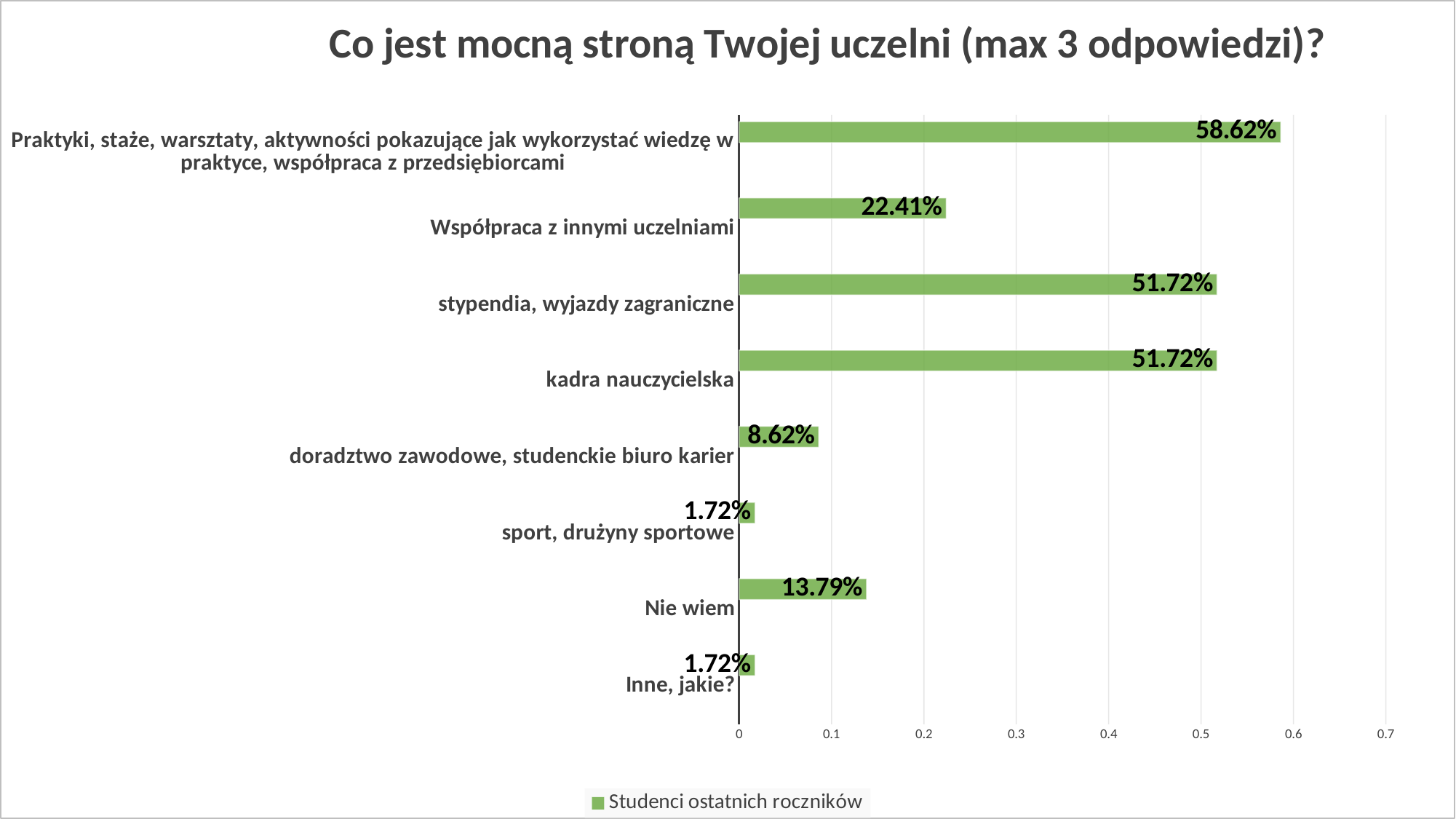
What is the value for "doradztwo zawodowe, studenckie biuro karier"? 8.62% How many series does the legend list? 1 Which is larger: the value for "Nie wiem" or the value for "doradztwo zawodowe, studenckie biuro karier"? Nie wiem What type of chart is shown on the slide? bar chart Which category has the highest value? Praktyki, staże, warsztaty, aktywności pokazujące jak wykorzystać wiedzę w praktyce, współpraca z przedsiębiorcami What is the title of the chart? Co jest mocną stroną Twojej uczelni (max 3 odpowiedzi)? What is the value for "Nie wiem"? 13.79% What is the name of the series shown in the legend? Studenci ostatnich roczników What is the value for "Współpraca z innymi uczelniami"? 22.41% What is the value for "kadra nauczycielska"? 51.72% What is the difference between the value for "stypendia, wyjazdy zagraniczne" and the value for "Współpraca z innymi uczelniami"? 29.31% How many categories are shown in the chart? 8